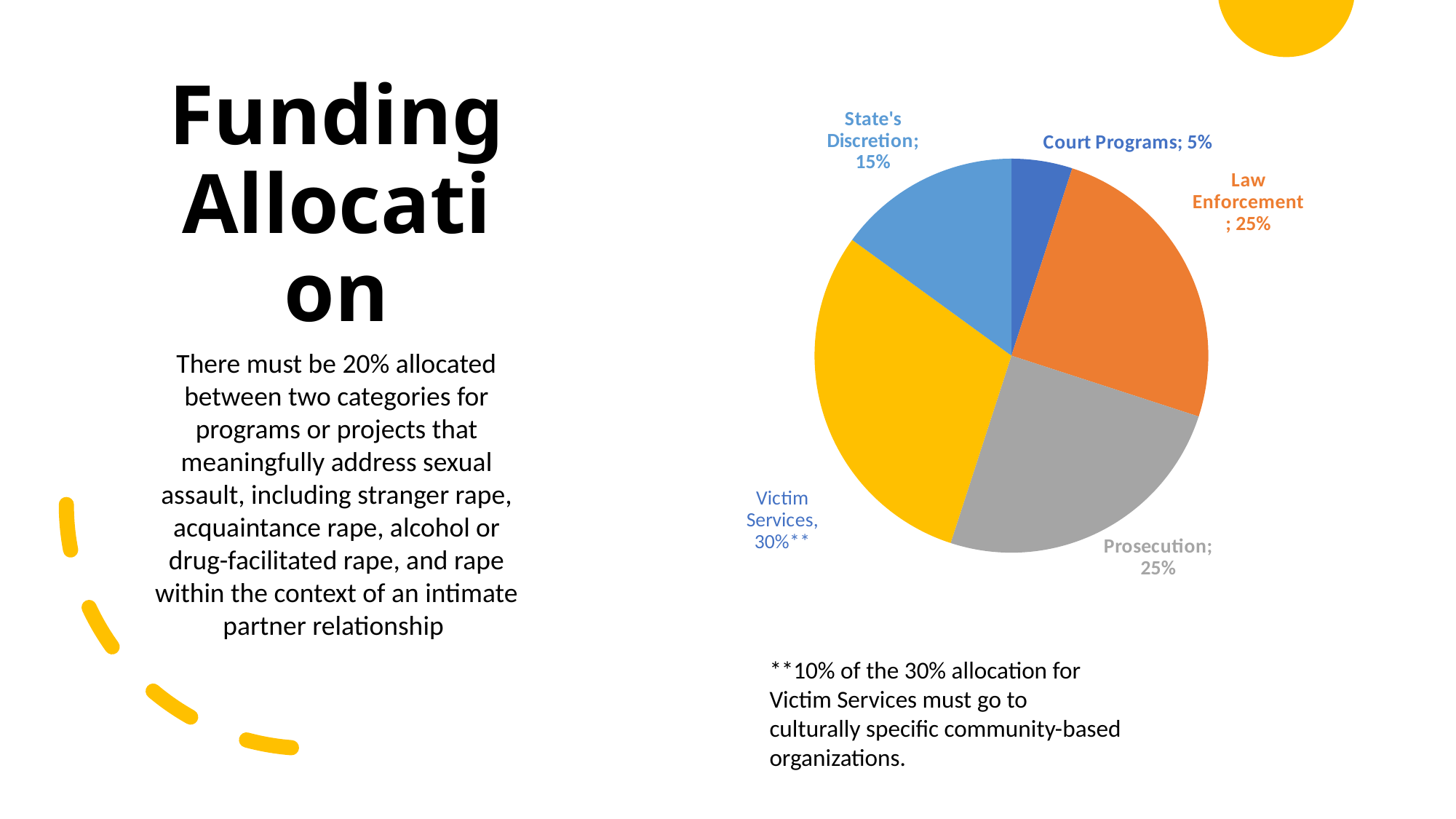
What percentage of funding is allocated to Victim Services? 30% Which category receives the smallest share of funding? Court Programs What kind of chart is shown on the slide? pie chart What percentage of funding is allocated to State's Discretion? 15% What percentage of funding is allocated to Law Enforcement? 25% What percentage of funding is allocated to Court Programs? 5% What is the difference between the Victim Services share and the State's Discretion share? 15% Which category receives the largest share of funding? Victim Services What is the combined share of Law Enforcement and Prosecution? 50% Which is larger, the share for Prosecution or the share for Court Programs? Prosecution How many categories are shown in the pie chart? 5 What colour is the Victim Services slice? yellow